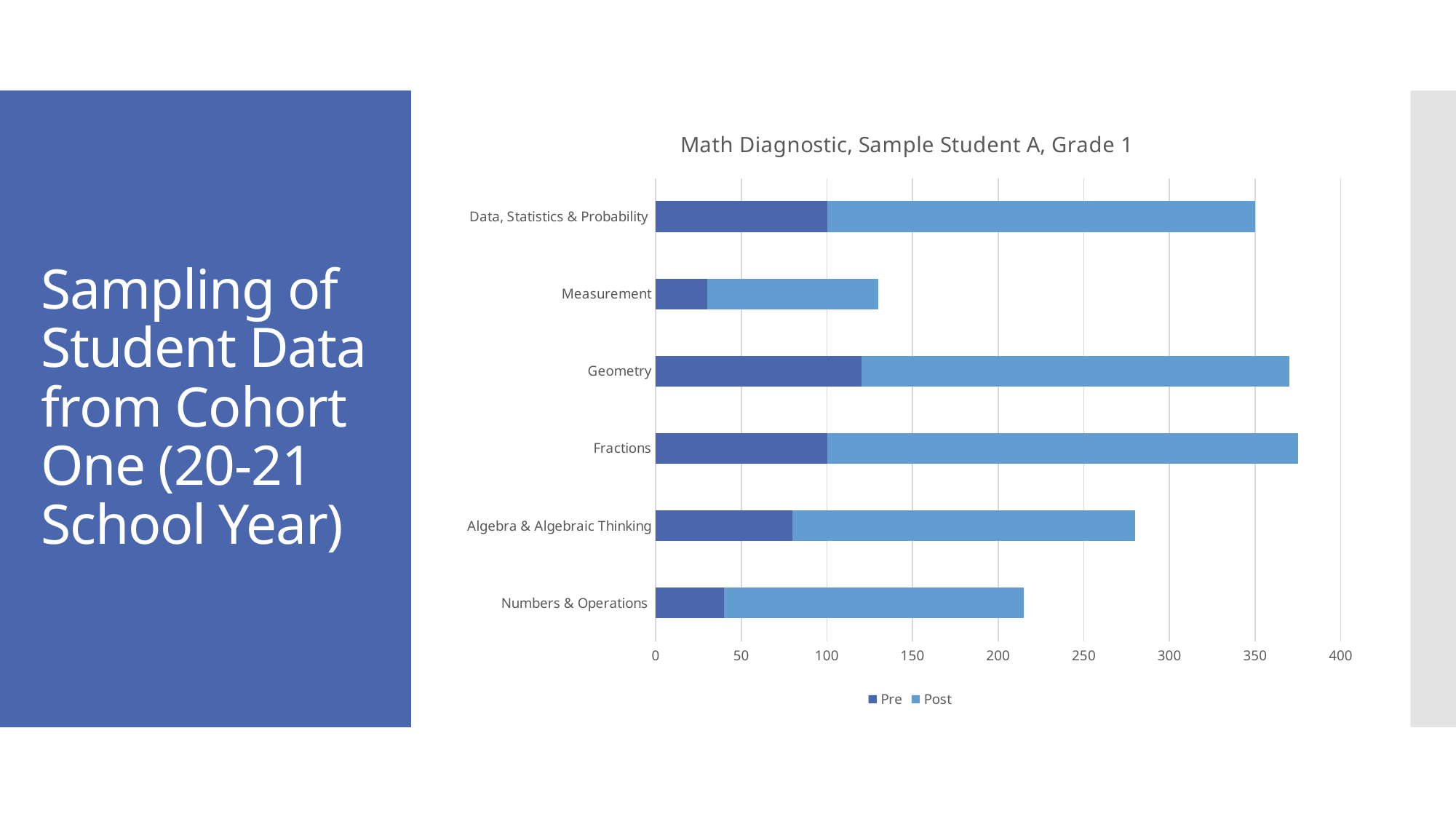
How many series does the legend list? 2 What kind of chart is shown on the slide? Stacked bar chart What is the Pre value for Data, Statistics & Probability? 100 Is the total stacked bar for Numbers & Operations greater or less than 250? less Which category has the shortest total stacked bar? Measurement What is the total length of the stacked bar for Data, Statistics & Probability? 350 Which has the longer total stacked bar, Geometry or Measurement? Geometry How many categories are shown on the chart? 6 What are the two series named in the legend? Pre and Post Which category has the largest Pre value? Geometry What is the title of the chart? Math Diagnostic, Sample Student A, Grade 1 Is the total stacked bar for Algebra & Algebraic Thinking greater or less than 250? greater